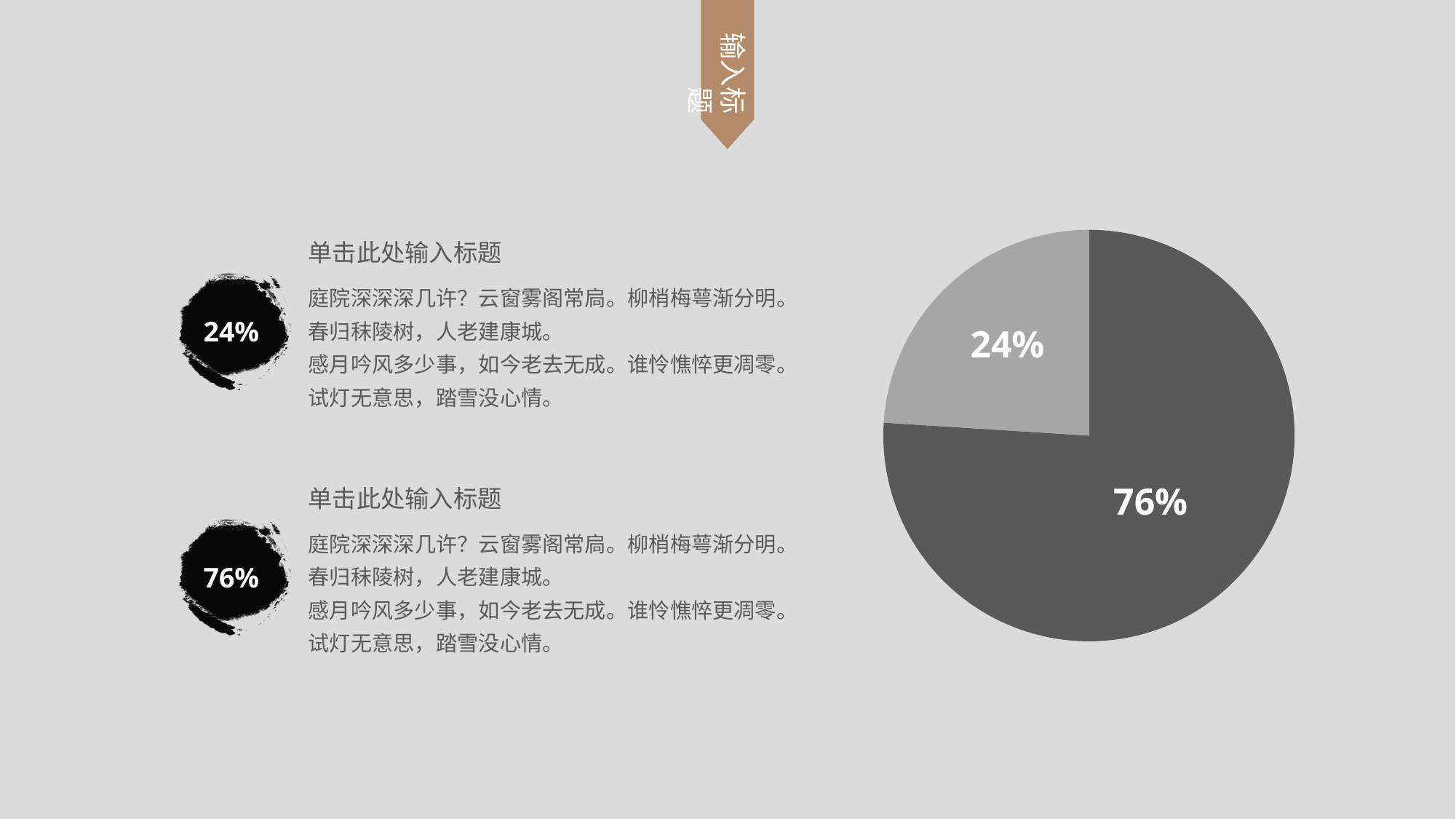
What kind of chart is shown on the right side of the slide? pie chart Does the pie chart display a legend? No What value is labelled on the light gray slice of the pie chart? 24% Is the value of the dark gray slice in the pie chart greater or less than 50%? greater What is the difference between the two slice values in the pie chart? 52% What is the value shown on the larger slice of the pie chart? 76% Which slice of the pie chart is larger, the light gray one or the dark gray one? the dark gray one What is the value shown on the smaller slice of the pie chart? 24% What do the two slice values in the pie chart add up to? 100% What value is labelled on the dark gray slice of the pie chart? 76% How many slices does the pie chart have? 2 Is the value of the light gray slice in the pie chart greater or less than 50%? less